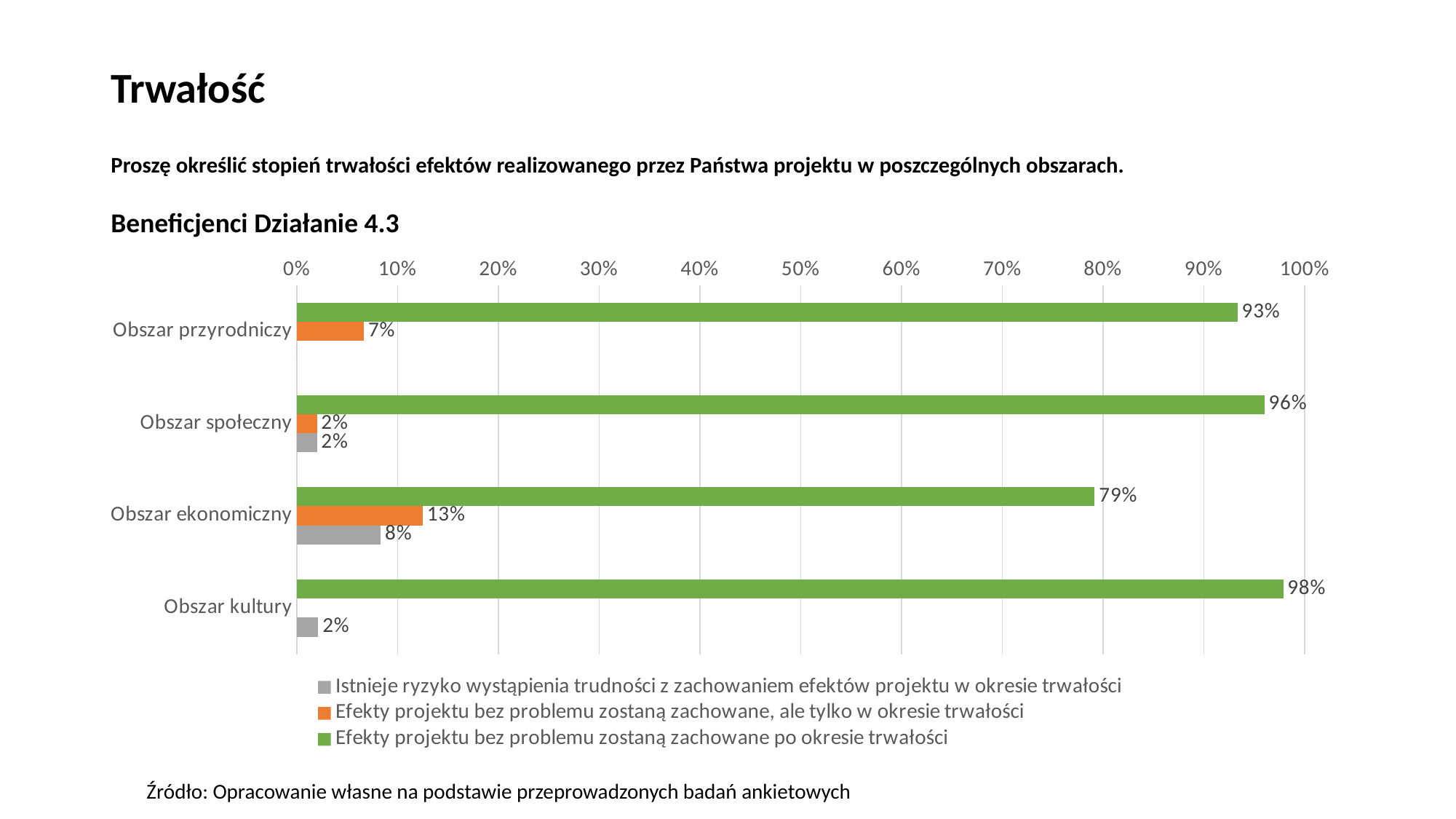
Which is larger: the orange bar for Obszar przyrodniczy or the orange bar for Obszar ekonomiczny? Obszar ekonomiczny How many series does the legend list? 3 Which category has the lowest value for 'Efekty projektu bez problemu zostaną zachowane po okresie trwałości'? Obszar ekonomiczny Which category has the highest value for 'Efekty projektu bez problemu zostaną zachowane po okresie trwałości'? Obszar kultury What kind of chart is shown on the slide? bar chart What is the title of the chart? Beneficjenci Działanie 4.3 How many categories are shown on the chart? 4 Is the green bar value for Obszar ekonomiczny greater or less than 80%? less What is the value of 'Istnieje ryzyko wystąpienia trudności z zachowaniem efektów projektu w okresie trwałości' for Obszar kultury? 2% What is the difference between the green bar values for Obszar społeczny and Obszar ekonomiczny? 17% What is the value of 'Efekty projektu bez problemu zostaną zachowane, ale tylko w okresie trwałości' for Obszar ekonomiczny? 13% What is the value of 'Efekty projektu bez problemu zostaną zachowane po okresie trwałości' for Obszar przyrodniczy? 93%